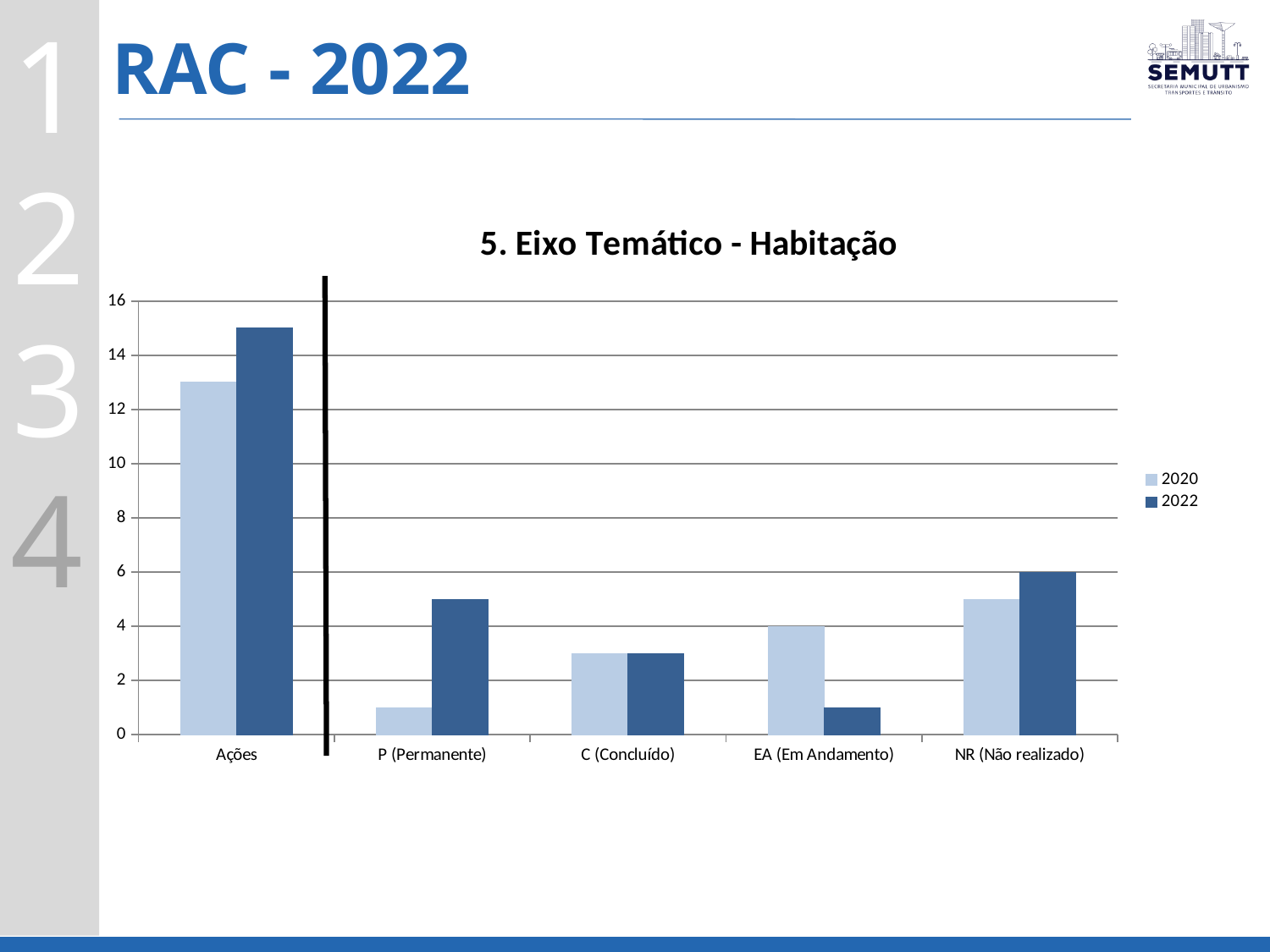
Is the 2020 value for P (Permanente) greater or less than 2? less Which category has the highest 2022 value? Ações Which category has the lowest 2020 value? P (Permanente) For EA (Em Andamento), which is larger, the 2020 value or the 2022 value? 2020 What type of chart is shown on the slide? bar chart Is the 2022 value for Ações greater or less than 14? greater How many categories are shown on the x axis? 5 What is the title of the chart? 5. Eixo Temático - Habitação For P (Permanente), which is larger, the 2020 value or the 2022 value? 2022 How many series does the legend list? 2 What is the 2020 value for EA (Em Andamento)? 4 What is the 2022 value for NR (Não realizado)? 6